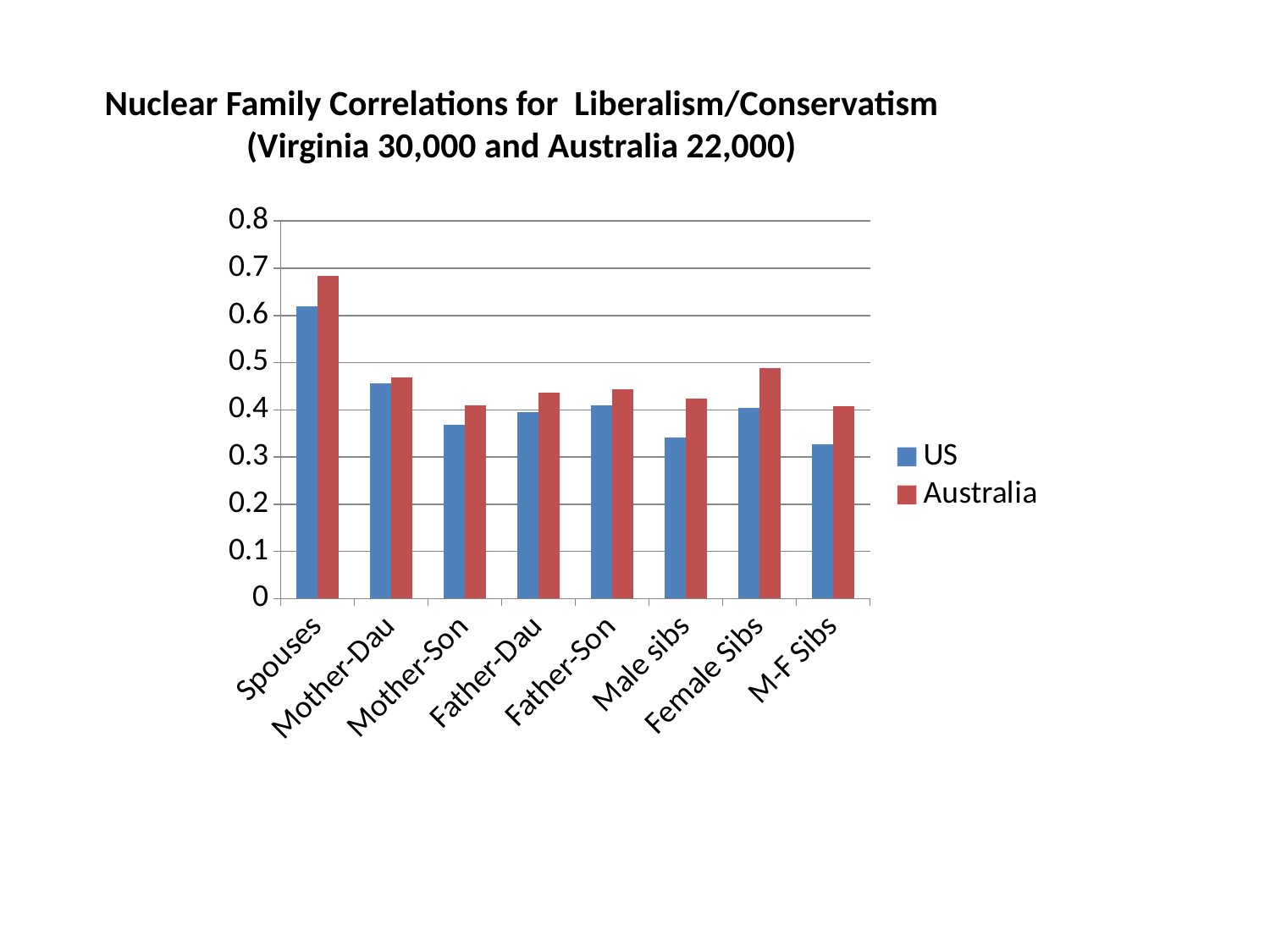
Is the US value for Mother-Dau greater or less than 0.4? greater How many series does the legend list? 2 What are the two entries in the legend? US and Australia How many family-pair categories are shown on the x axis? 8 Which is larger for the US series: Spouses or Mother-Dau? Spouses Is the Australia value for Spouses greater or less than 0.6? greater Which category has the highest US correlation? Spouses Is the Australia value for Female Sibs greater or less than 0.4? greater What kind of chart is shown on the slide? bar chart For Male sibs, which series has the larger value, US or Australia? Australia Which category has the highest Australia correlation? Spouses